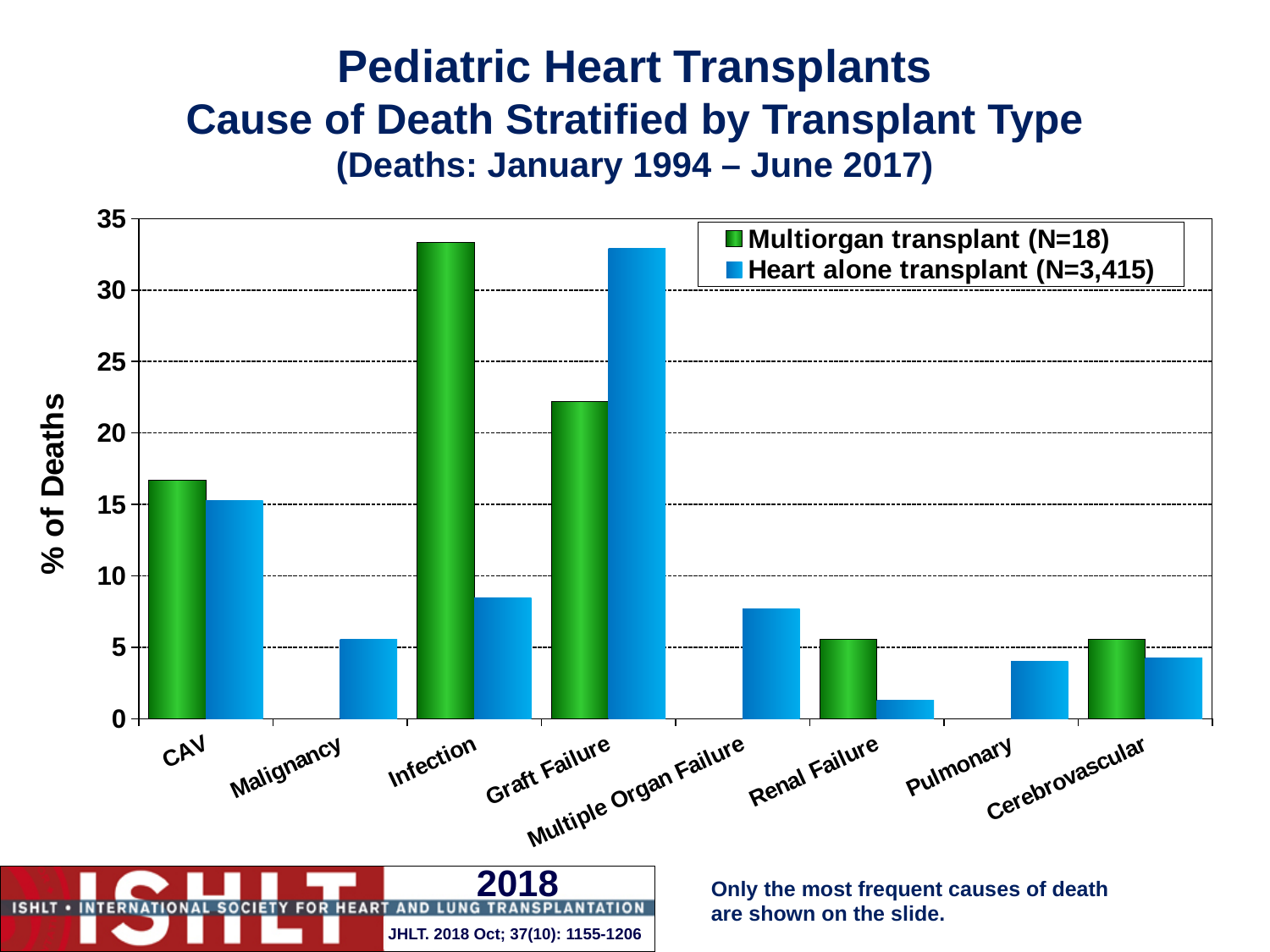
How many cause-of-death categories are shown on the x axis? 8 For Infection, which series has the larger percentage of deaths: Multiorgan transplant or Heart alone transplant? Multiorgan transplant What is the N shown in the legend for Heart alone transplant? N=3,415 How many series does the legend list? 2 Is the Heart alone transplant value for Renal Failure greater or less than 5? less What kind of chart is shown on the slide? bar chart Among the causes with a visible bar, which has the lowest percentage for Heart alone transplant? Renal Failure Which cause of death has the highest percentage for Multiorgan transplant? Infection Is the Multiorgan transplant value for Graft Failure greater or less than 20? greater Is the Multiorgan transplant value for Infection greater or less than 30? greater For Graft Failure, which series has the larger percentage of deaths: Multiorgan transplant or Heart alone transplant? Heart alone transplant Which cause of death has the highest percentage for Heart alone transplant? Graft Failure